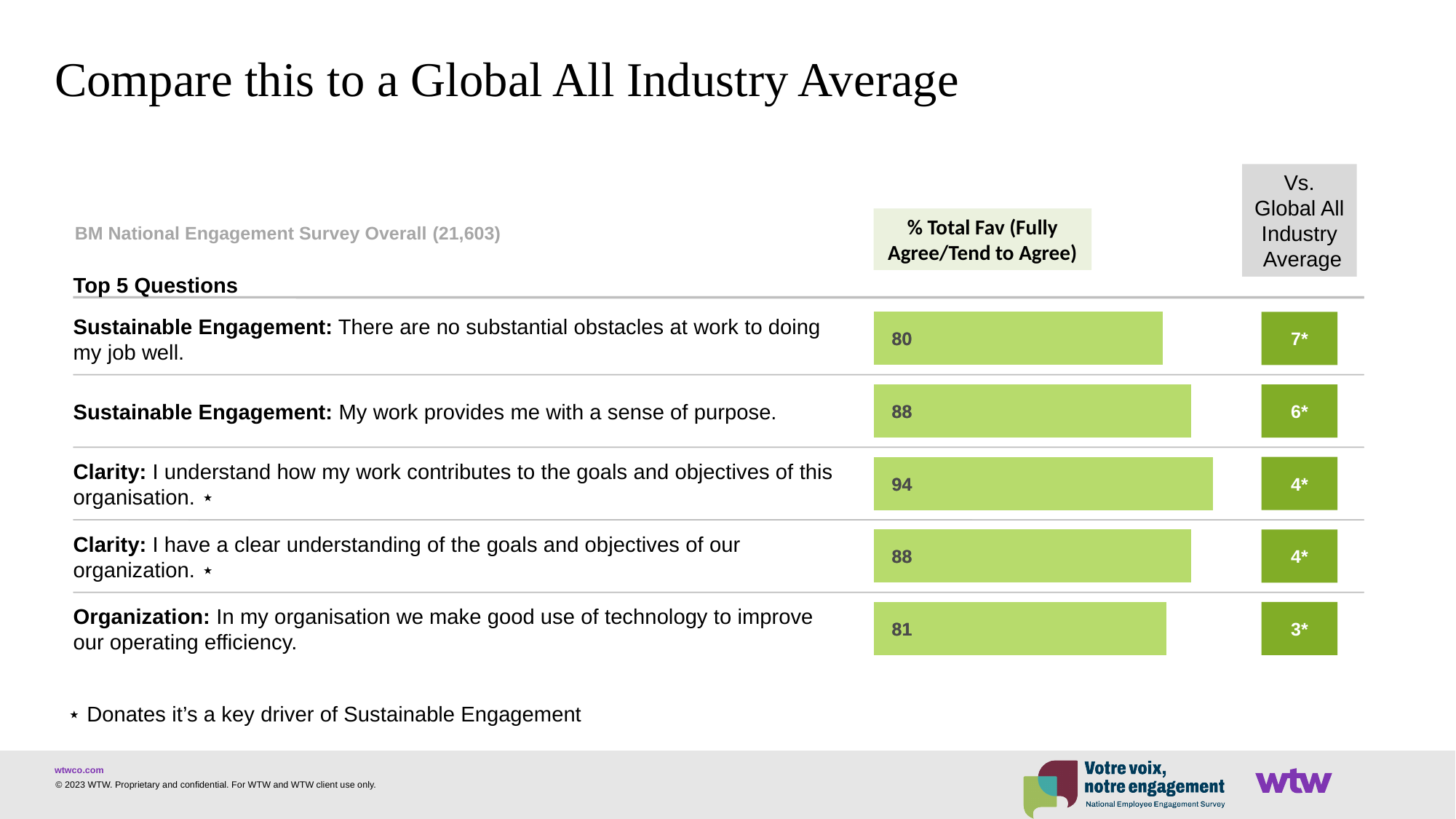
How many questions are shown in the chart? 5 Which question has the highest % Total Fav value? Clarity: I understand how my work contributes to the goals and objectives of this organisation. What is the survey sample size shown in the chart's subtitle? 21,603 What is the difference in % Total Fav between "Clarity: I understand how my work contributes to the goals and objectives of this organisation" and "Organization: In my organisation we make good use of technology to improve our operating efficiency"? 13 What is the % Total Fav value for "Sustainable Engagement: There are no substantial obstacles at work to doing my job well"? 80 Which question has the lowest % Total Fav value? Sustainable Engagement: There are no substantial obstacles at work to doing my job well. What is the Vs. Global All Industry Average value for "Sustainable Engagement: My work provides me with a sense of purpose"? 6* Which has a higher % Total Fav value: "Sustainable Engagement: My work provides me with a sense of purpose" or "Organization: In my organisation we make good use of technology to improve our operating efficiency"? Sustainable Engagement: My work provides me with a sense of purpose. What is the % Total Fav value for "Organization: In my organisation we make good use of technology to improve our operating efficiency"? 81 Which question has the largest Vs. Global All Industry Average value? Sustainable Engagement: There are no substantial obstacles at work to doing my job well. What kind of chart is used to show the % Total Fav values? Bar chart What is the % Total Fav value for "Clarity: I understand how my work contributes to the goals and objectives of this organisation"? 94